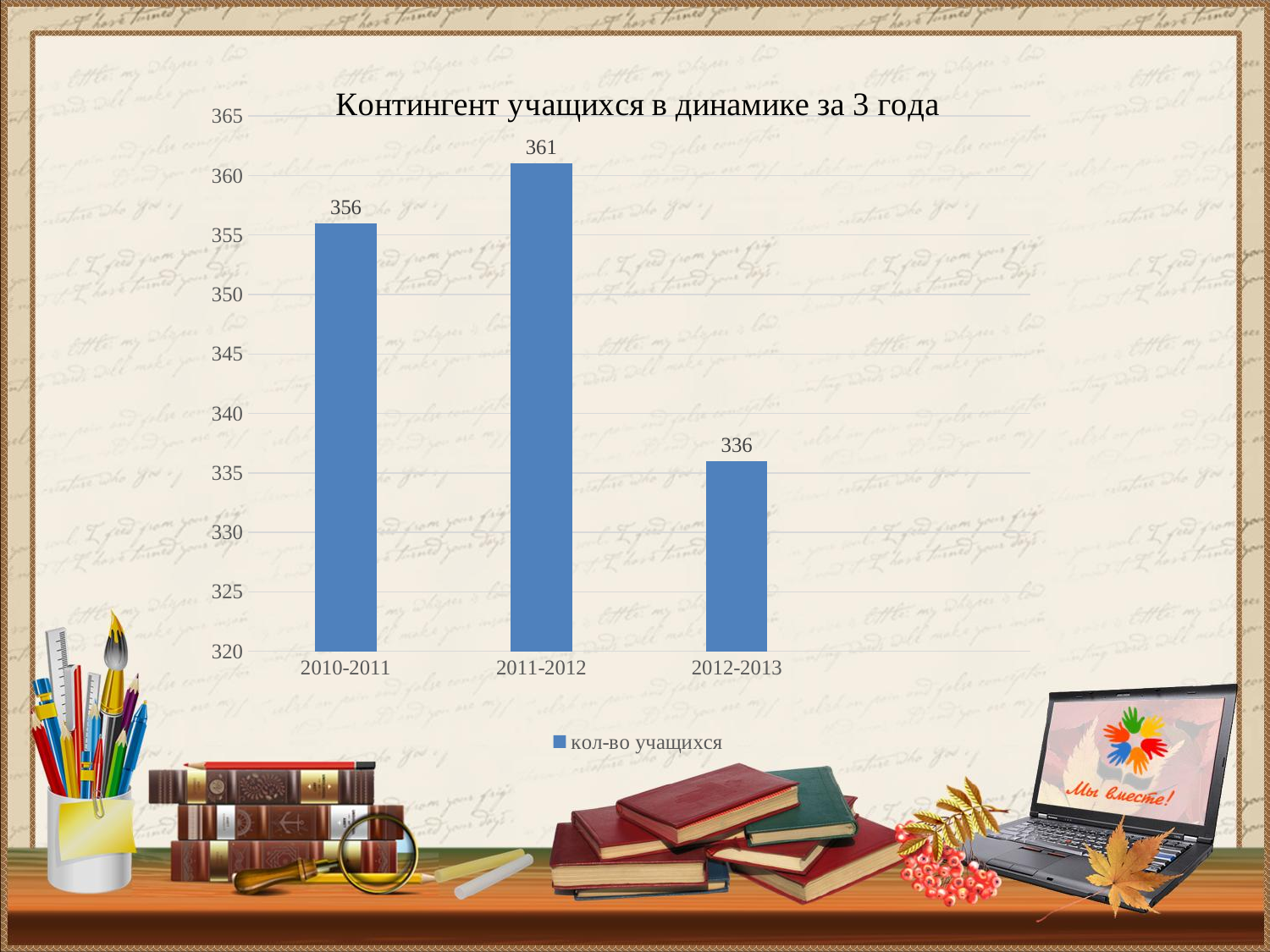
Which year has the lowest number of students? 2012-2013 What is the difference between the values for 2011-2012 and 2012-2013? 25 Is the value for 2012-2013 greater or less than 340? less What is the title of the chart? Контингент учащихся в динамике за 3 года What kind of chart is shown on the slide? bar chart What is the value for 2010-2011? 356 Which is larger, the value for 2010-2011 or the value for 2012-2013? 2010-2011 How many categories are shown on the x axis? 3 What is the value for 2012-2013? 336 What is the difference between the values for 2010-2011 and 2011-2012? 5 What is the value for 2011-2012? 361 Which year has the highest number of students? 2011-2012